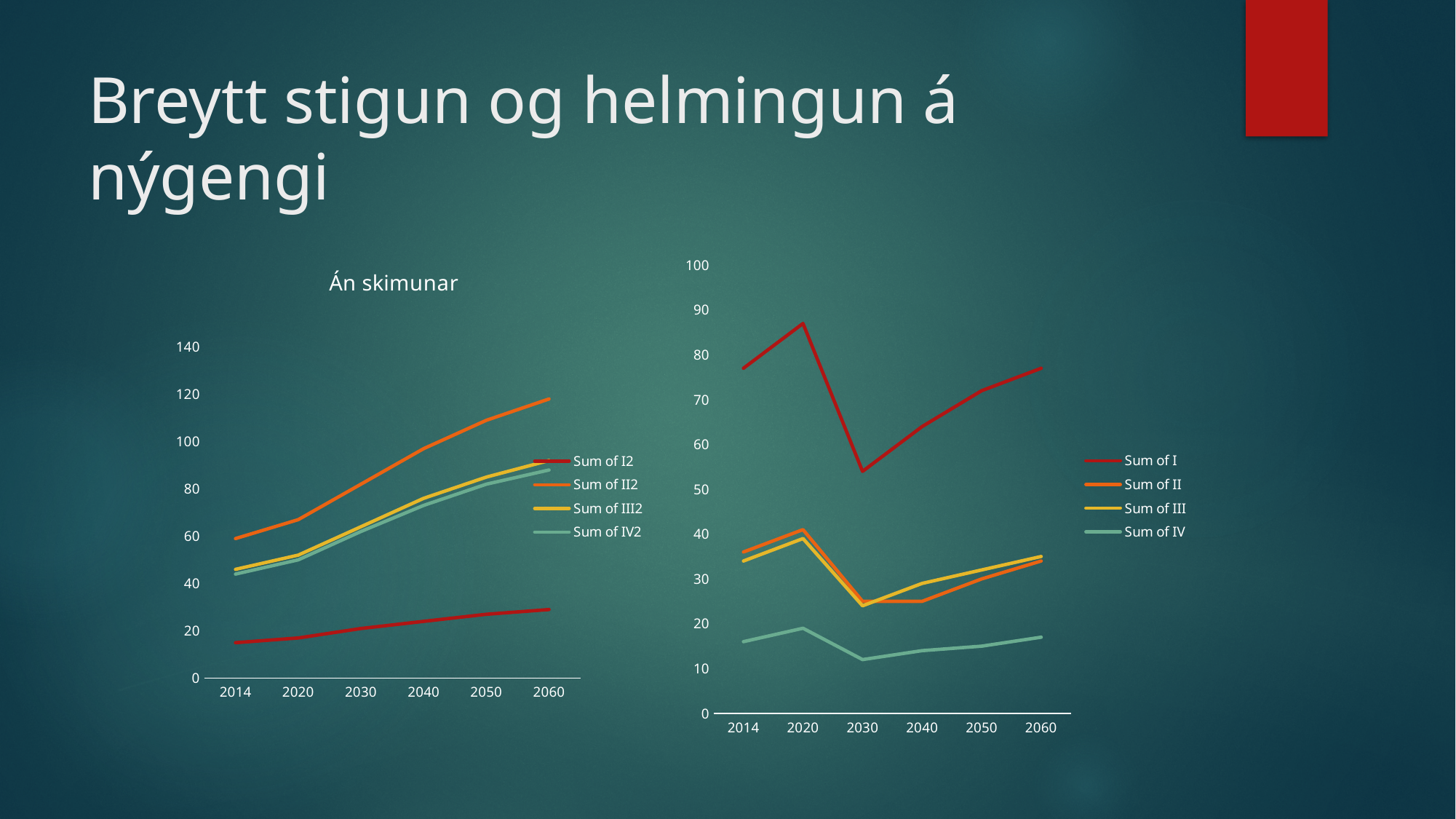
In the chart on the right, is the value for Sum of IV in 2030 greater or less than 20? less What type of chart is the 'Án skimunar' chart? line chart In the 'Án skimunar' chart, do the values for Sum of II2 rise or fall from 2014 to 2060? rise In the chart on the right, in which year does Sum of I reach its lowest value? 2030 In the chart on the right, in which year does Sum of I reach its highest value? 2020 In the chart on the right, which is larger in 2014: Sum of I or Sum of II? Sum of I In the 'Án skimunar' chart, which series has the highest value in 2060? Sum of II2 In the 'Án skimunar' chart, which series has the lowest value in 2060? Sum of I2 In the 'Án skimunar' chart, is the value for Sum of I2 in 2014 greater or less than 20? less How many series does the legend of the 'Án skimunar' chart list? 4 In the 'Án skimunar' chart, is the value for Sum of II2 in 2060 greater or less than 100? greater How many years are shown on the x axis of the 'Án skimunar' chart? 6